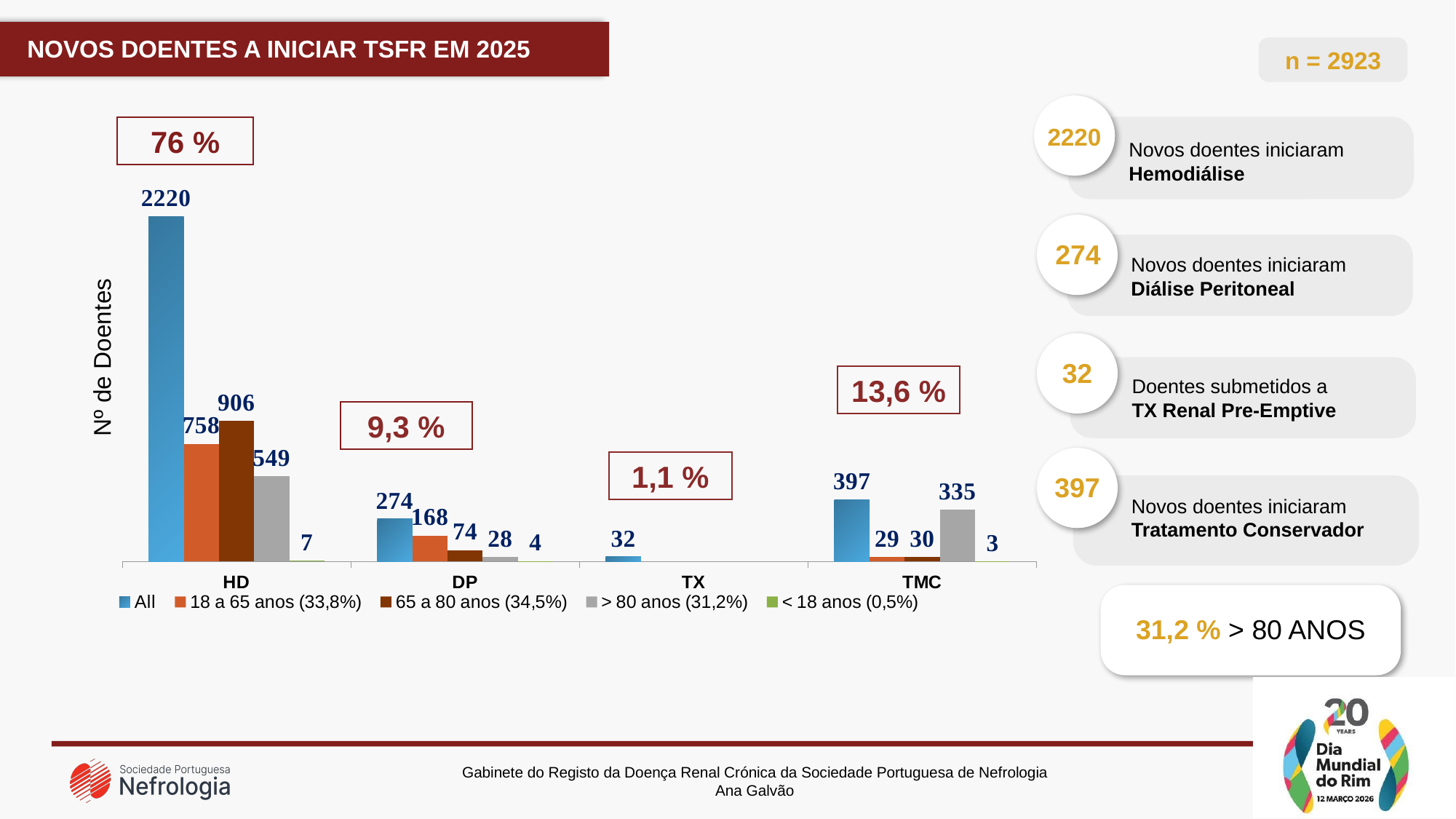
How many categories are shown on the x axis? 4 Which is larger for HD: the "18 a 65 anos" value or the "65 a 80 anos" value? 65 a 80 anos What is the difference between the "All" values for HD and TMC? 1823 What is the value of the "65 a 80 anos" series for DP? 74 What kind of chart is shown on the slide? Bar chart Which category has the lowest value in the "All" series? TX Which category has the highest value in the "All" series? HD How many series does the legend list? 5 What percentage is shown in the box above the TMC group? 13,6 % What is the label of the y axis? Nº de Doentes What is the value of the "> 80 anos" series for TMC? 335 What is the value of the "All" series for HD? 2220